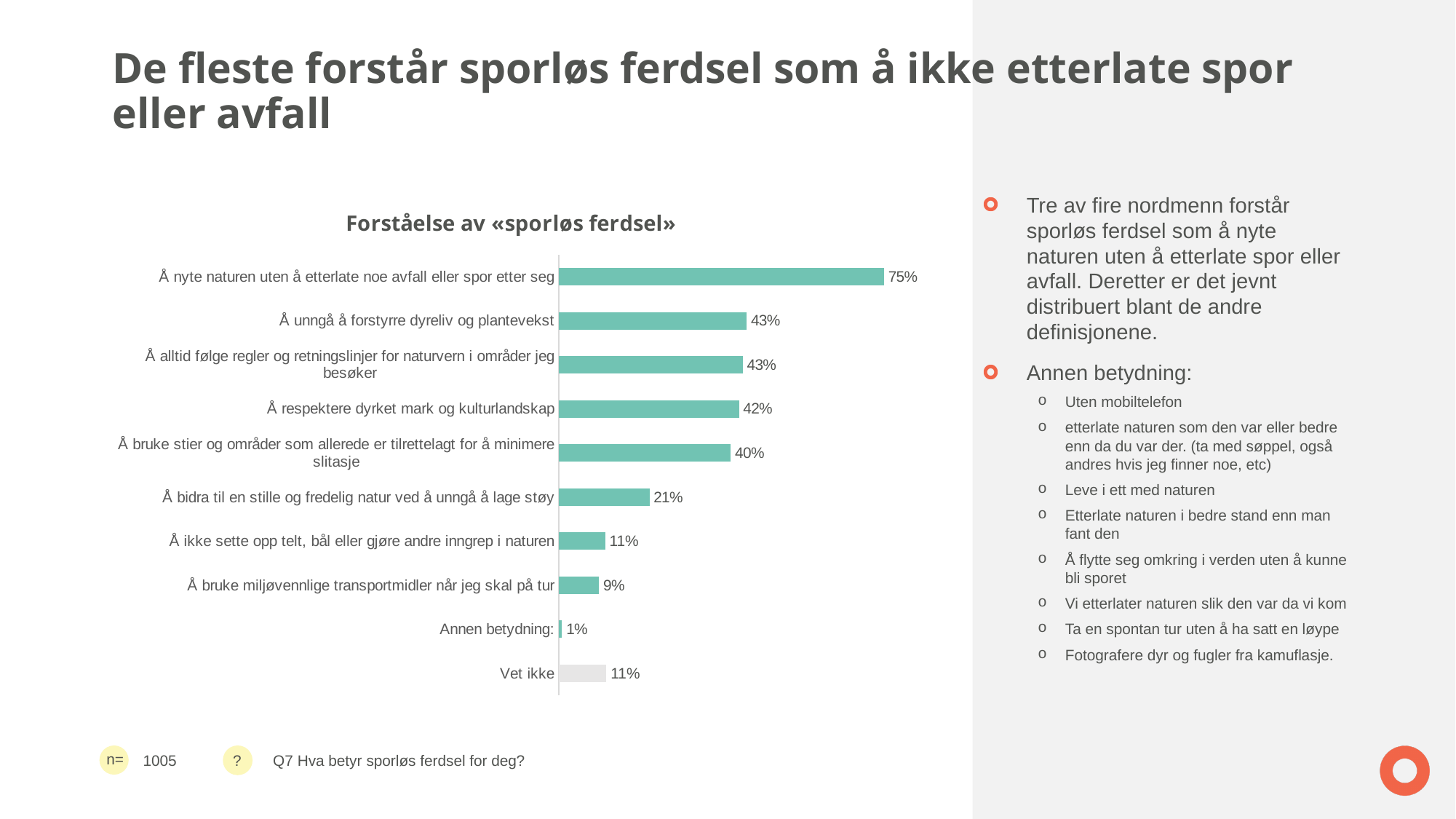
Which category has the lowest value? Annen betydning: Which bar is shown in a different colour (grey) from the others? Vet ikke What is the value for "Å nyte naturen uten å etterlate noe avfall eller spor etter seg"? 75% What is the value for "Å bidra til en stille og fredelig natur ved å unngå å lage støy"? 21% Which category has the highest value? Å nyte naturen uten å etterlate noe avfall eller spor etter seg What kind of chart is shown on the slide? Bar chart What is the difference between the values for "Å nyte naturen uten å etterlate noe avfall eller spor etter seg" and "Å unngå å forstyrre dyreliv og plantevekst"? 32% Which is larger: the value for "Å respektere dyrket mark og kulturlandskap" or the value for "Å bruke stier og områder som allerede er tilrettelagt for å minimere slitasje"? Å respektere dyrket mark og kulturlandskap What is the title of the chart? Forståelse av «sporløs ferdsel» How many categories are shown in the chart? 10 What is the value for "Vet ikke"? 11% What is the value for "Å bruke miljøvennlige transportmidler når jeg skal på tur"? 9%